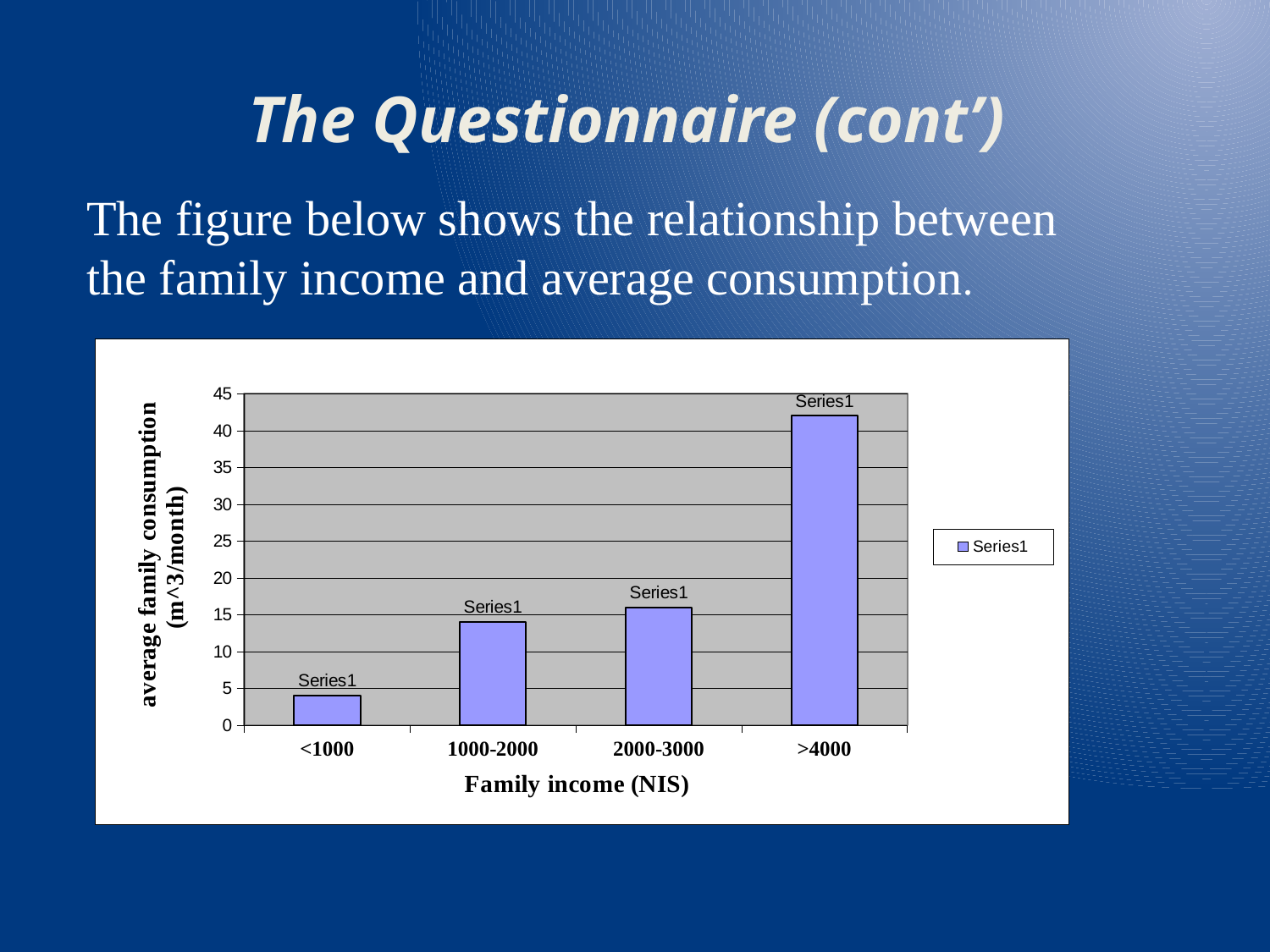
Is the value for <1000 greater or less than 5? less Is the value for 2000-3000 greater or less than 20? less Which family income category has the lowest average family consumption? <1000 Which has a larger average family consumption, <1000 or >4000? >4000 How many series does the legend list? 1 Is the value for 1000-2000 greater or less than 10? greater What kind of chart is shown on the slide? bar chart How many family income categories are shown on the x axis? 4 What is the title of the x axis? Family income (NIS) Which family income category has the highest average family consumption? >4000 Do the values rise or fall as family income increases along the x axis? rise